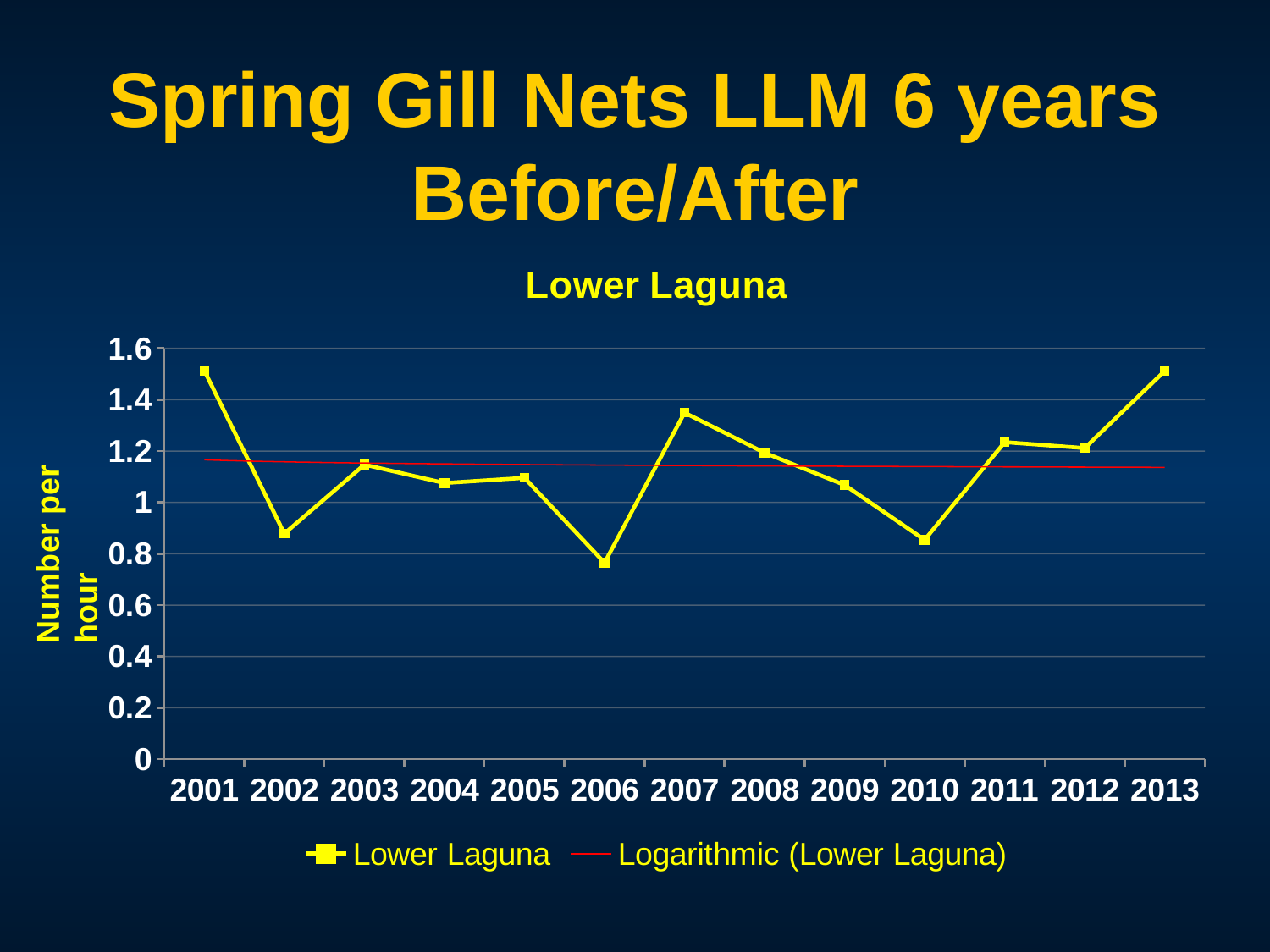
What is the label on the y axis? Number per hour How many years are plotted along the x axis? 13 Is the value for 2001 greater or less than 1.4? greater Which year has the lowest value for Lower Laguna? 2006 What kind of chart is shown on the slide? line chart Is the value for 2002 greater or less than 1? less How many entries does the legend list? 2 Do the values rise or fall from 2010 to 2013? rise Is the value for 2007 greater or less than 1.2? greater Which year has the larger value, 2007 or 2008? 2007 What type of trendline is shown in the legend for Lower Laguna? Logarithmic